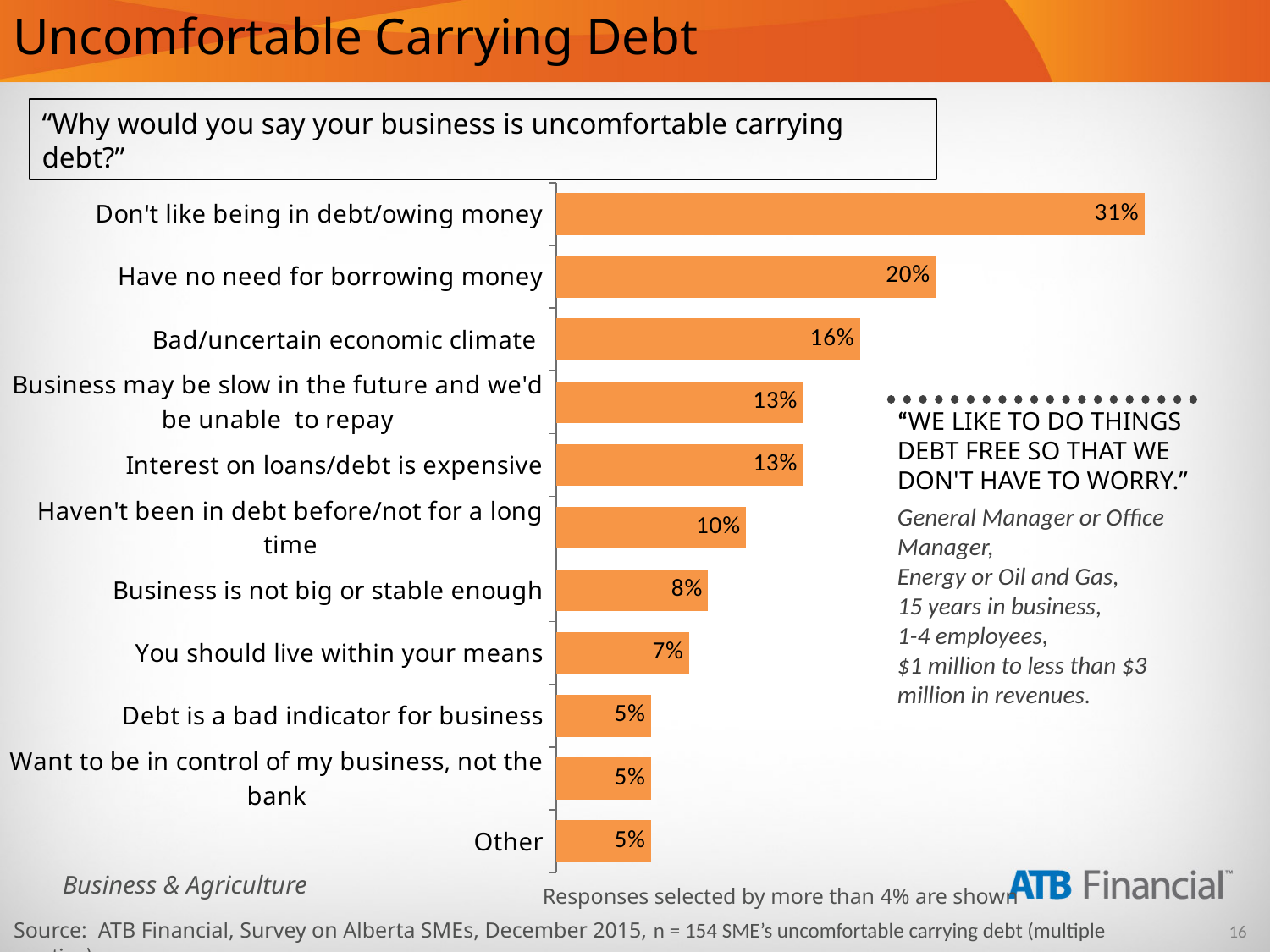
What is the value for "Bad/uncertain economic climate"? 16% Which is larger: "Haven't been in debt before/not for a long time" or "Debt is a bad indicator for business"? Haven't been in debt before/not for a long time Which reason has the highest percentage? Don't like being in debt/owing money What is the difference between "Have no need for borrowing money" and "Business is not big or stable enough"? 12% What is the value for "You should live within your means"? 7% How many categories are shown in the chart? 11 What is the difference between "Don't like being in debt/owing money" and "Have no need for borrowing money"? 11% How many categories share the lowest value of 5%? 3 What is the value for "Interest on loans/debt is expensive"? 13% What survey question does the chart answer, as shown in the box above it? "Why would you say your business is uncomfortable carrying debt?" What percentage of respondents said "Don't like being in debt/owing money"? 31% What kind of chart is shown on the slide? Bar chart